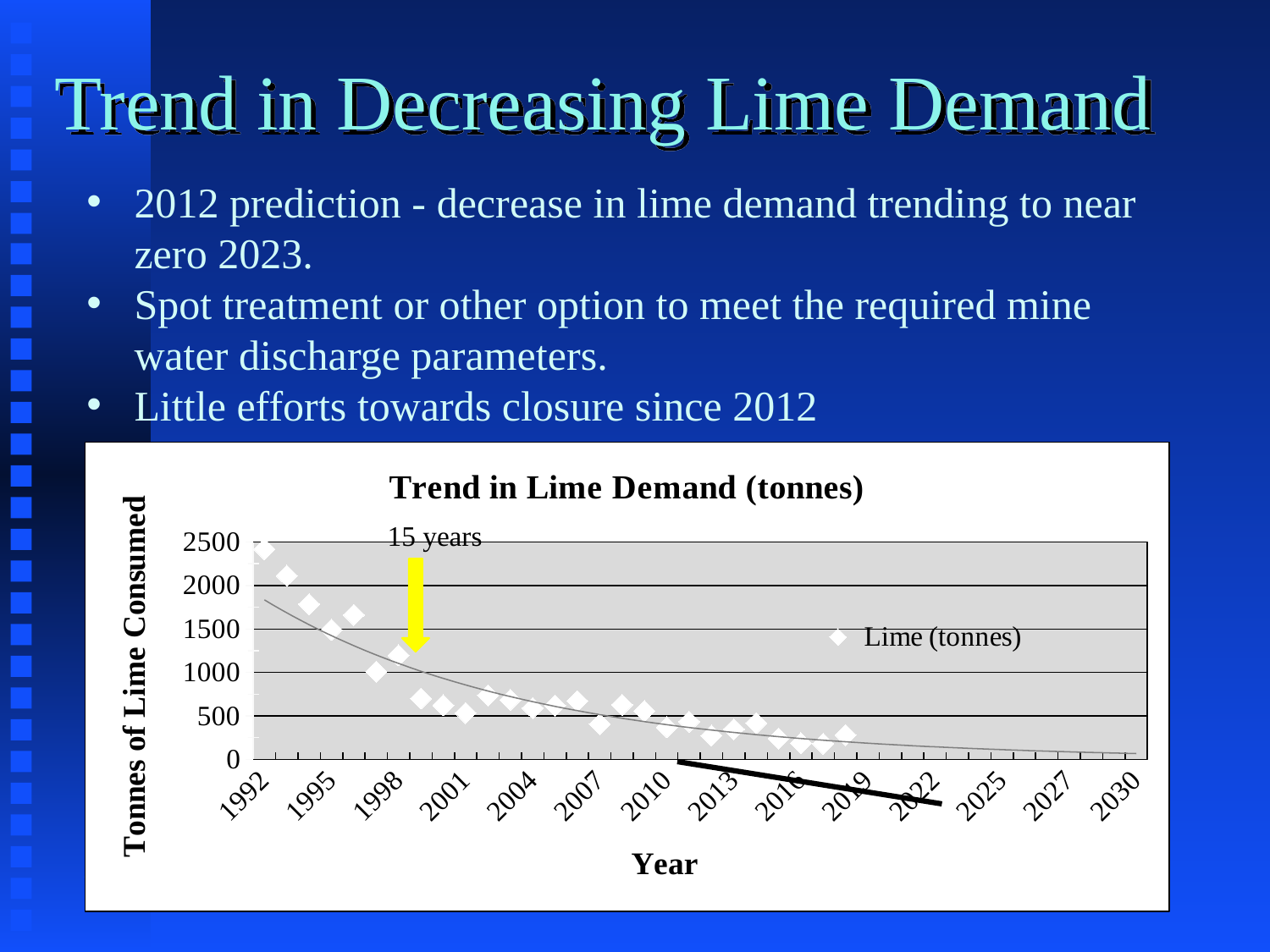
Is the value for 1992 greater or less than 2000? greater What is the title of the chart? Trend in Lime Demand (tonnes) Which year has the highest lime demand on the chart? 1992 Is the value for 2001 greater or less than 1000? less How many series does the chart legend list? 1 What is the name of the series shown in the legend? Lime (tonnes) What is the label on the y axis of the chart? Tonnes of Lime Consumed Is the value for 2010 greater or less than 1000? less Which is larger, the value for 1992 or the value for 2010? 1992 What kind of chart is shown on the slide? scatter chart Do the plotted lime values rise or fall as the years increase along the x axis? fall